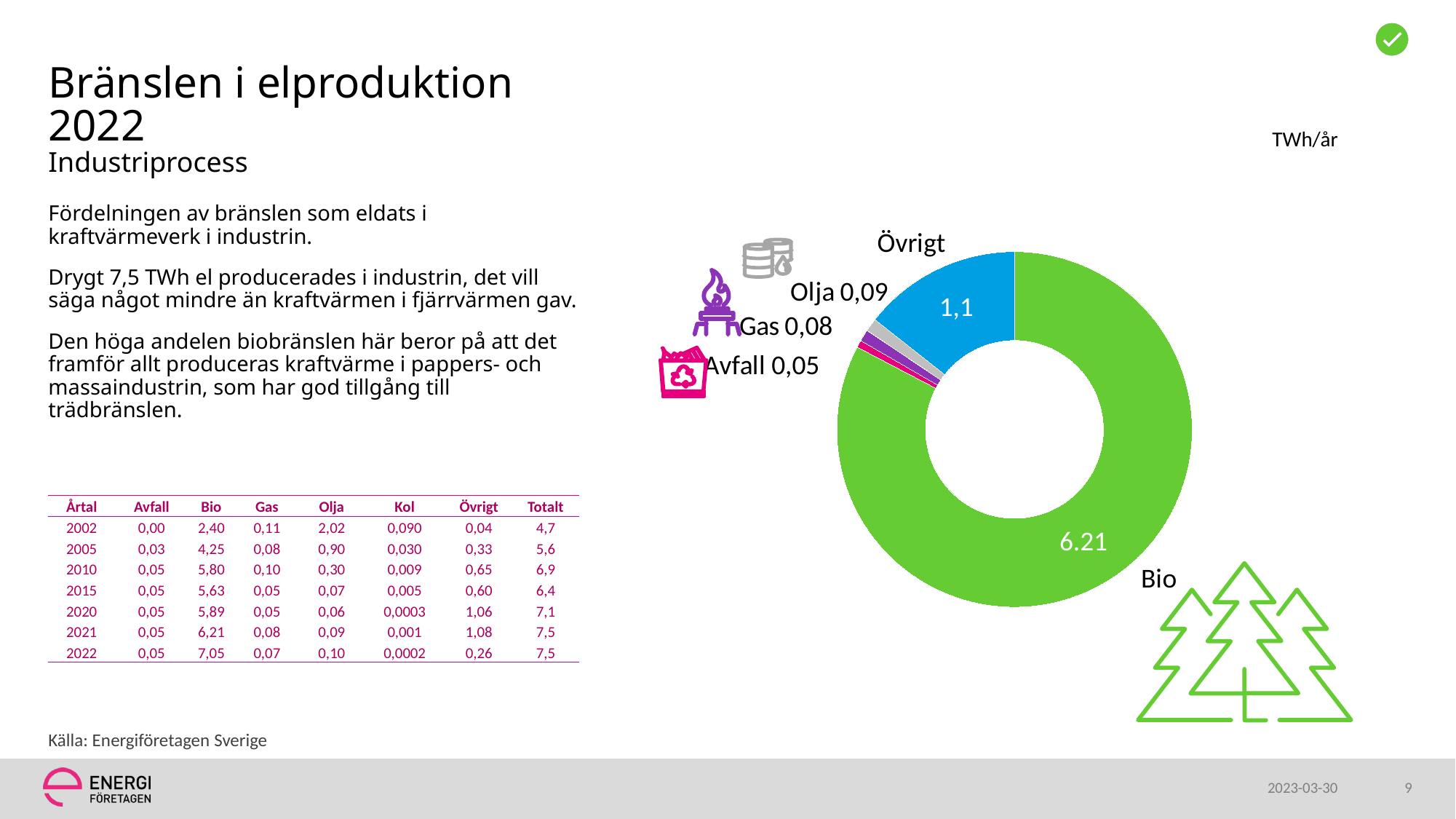
Which is larger on the donut chart, Olja or Gas? Olja Which category has the smallest labelled value on the donut chart? Avfall What is the difference between the values for Olja and Gas on the donut chart? 0,01 What is the value for Olja on the donut chart? 0,09 What is the value for Övrigt on the donut chart? 1,1 How many labelled categories are shown on the donut chart? 5 What unit is indicated for the values on the donut chart? TWh/år What kind of chart is shown on the slide? Pie (donut) chart Which category has the largest slice on the donut chart? Bio What is the value for Avfall on the donut chart? 0,05 What is the value for Bio on the donut chart? 6.21 What is the value for Gas on the donut chart? 0,08